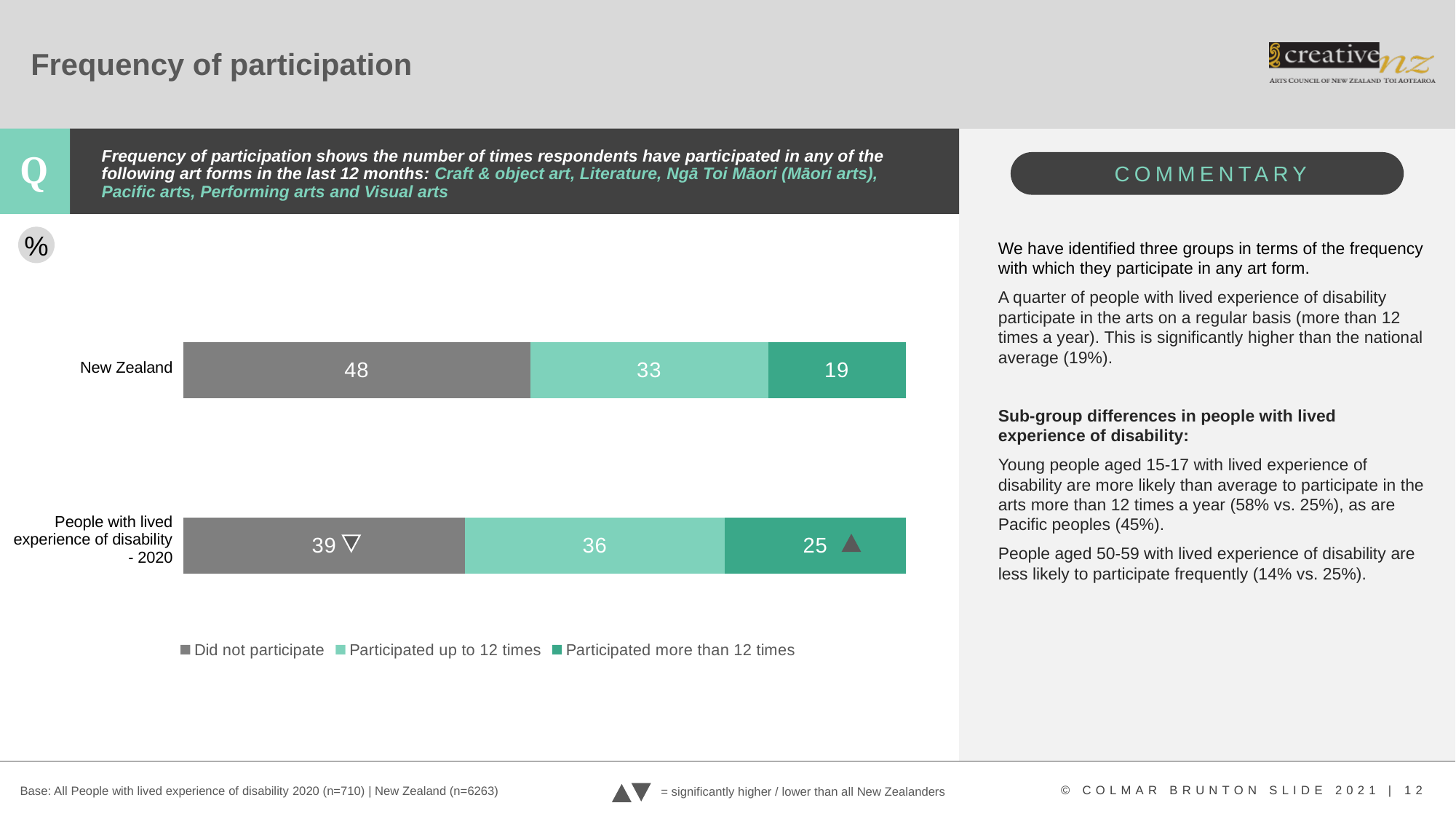
Which category has the higher value for 'Participated more than 12 times'? People with lived experience of disability - 2020 How many series does the legend list? 3 What is the third legend entry in the chart? Participated more than 12 times What is the value for 'Participated more than 12 times' for People with lived experience of disability - 2020? 25 What is the difference between the 'Did not participate' values for New Zealand and People with lived experience of disability - 2020? 9 Which series has the lowest value in the New Zealand bar? Participated more than 12 times How many categories (bars) are shown in the chart? 2 What is the total of the stacked bar for New Zealand? 100 What is the value for 'Participated up to 12 times' for New Zealand? 33 What is the value for 'Did not participate' for New Zealand? 48 What is the value for 'Did not participate' for People with lived experience of disability - 2020? 39 What kind of chart is shown on the slide? Stacked bar chart